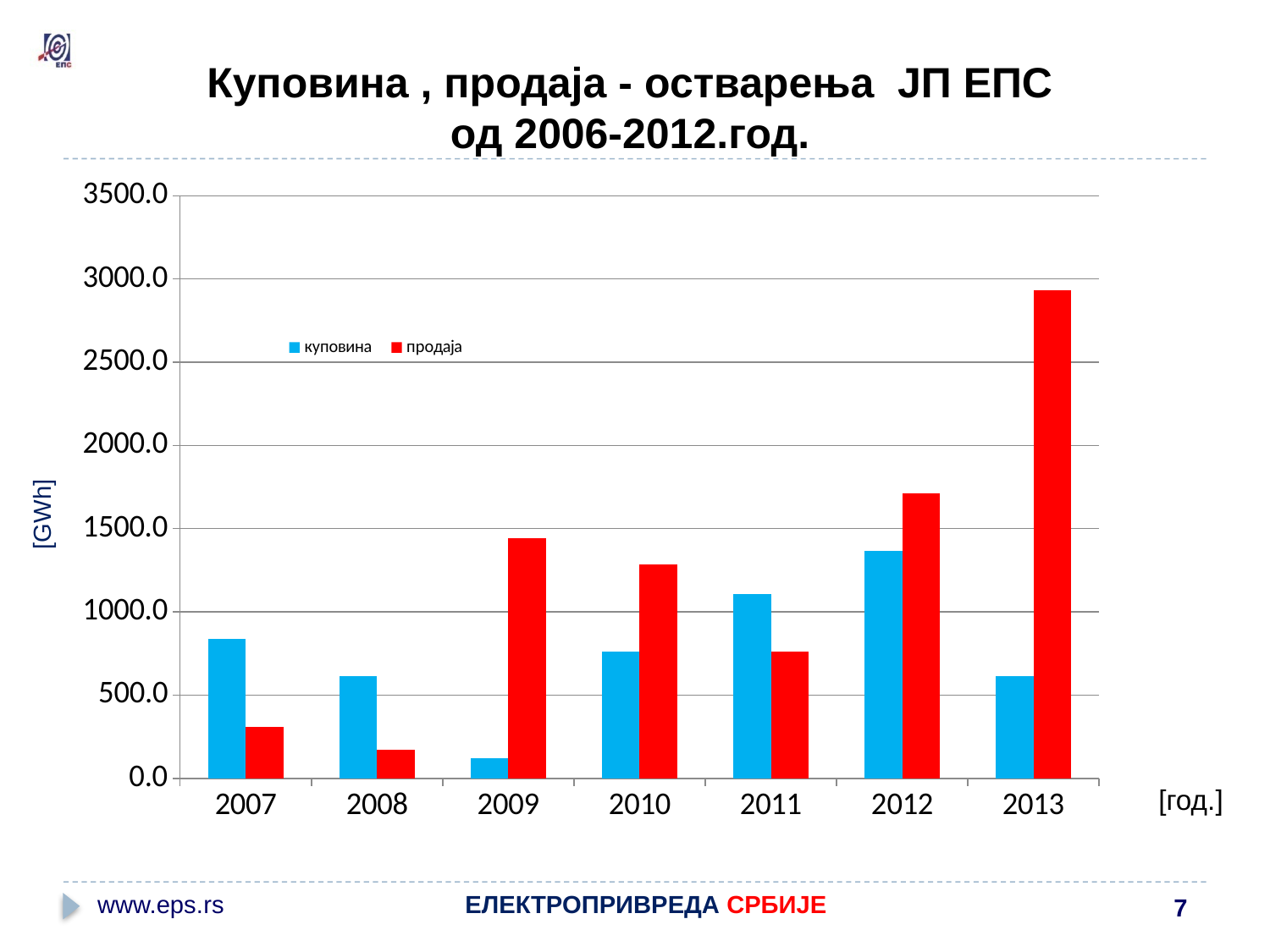
How many series does the legend list? 2 In which year is the продаја value highest? 2013 Is the куповина value for 2011 greater or less than 1000? greater In which year is the куповина value highest? 2012 In 2009, which is larger: куповина or продаја? продаја In which year is the продаја value lowest? 2008 In 2007, which is larger: куповина or продаја? куповина What unit is shown on the y axis? [GWh] In which year is the куповина value lowest? 2009 How many years are shown on the x axis? 7 What kind of chart is shown on the slide? bar chart Is the продаја value for 2013 greater or less than 2500? greater